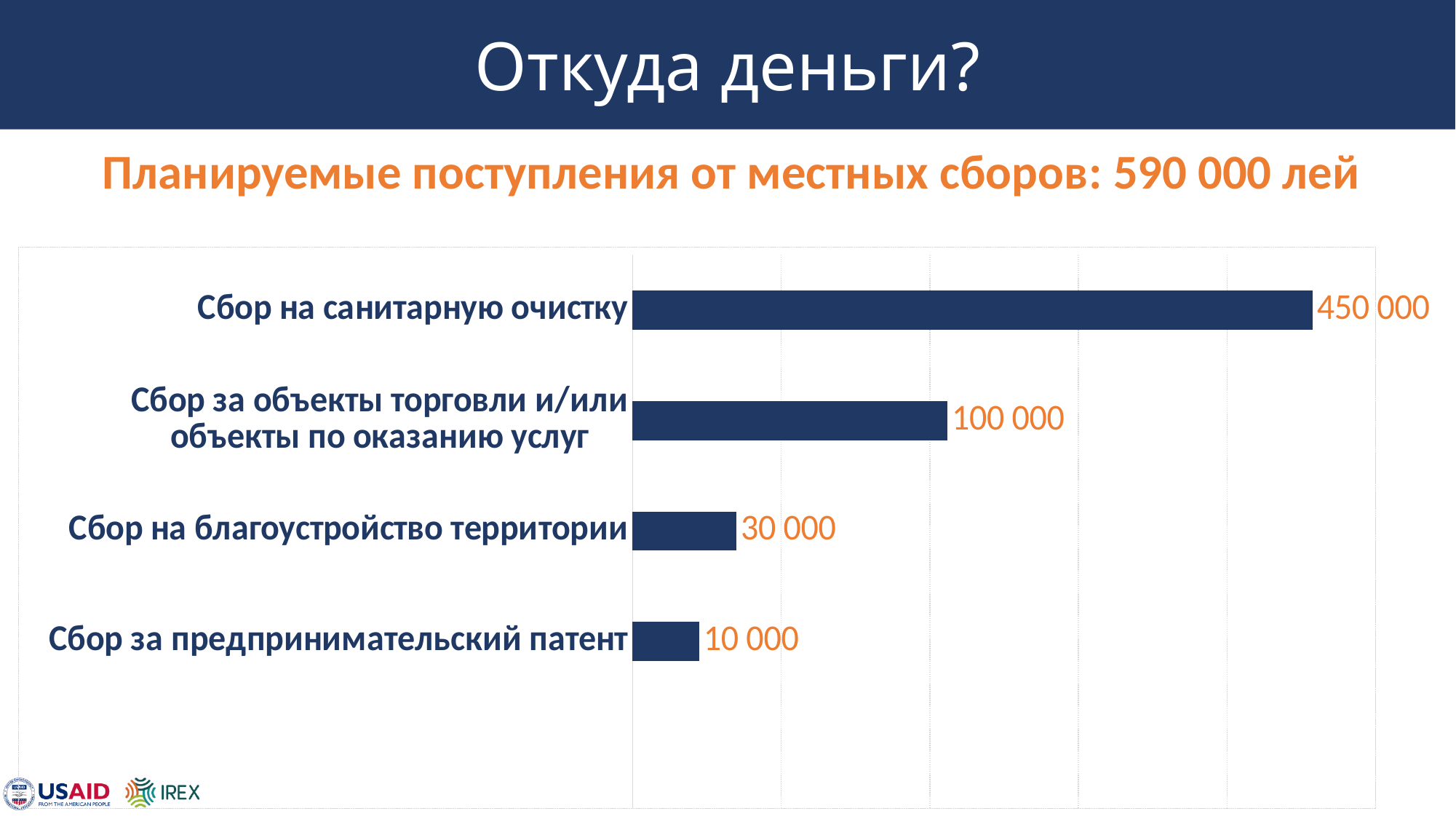
What is the value for Сбор за объекты торговли и/или объекты по оказанию услуг? 100 000 Which category has the lowest value? Сбор за предпринимательский патент What is the difference between the values for Сбор на санитарную очистку and Сбор за объекты торговли и/или объекты по оказанию услуг? 350 000 What is the difference between the values for Сбор на благоустройство территории and Сбор за предпринимательский патент? 20 000 What is the total of the four values shown in the chart? 590 000 How many categories are shown in the chart? 4 What is the value for Сбор на благоустройство территории? 30 000 What kind of chart is shown on the slide? Bar chart Which category has the highest value? Сбор на санитарную очистку What is the value for Сбор за предпринимательский патент? 10 000 Which is larger: the value for Сбор на благоустройство территории or the value for Сбор за предпринимательский патент? Сбор на благоустройство территории What is the value for Сбор на санитарную очистку? 450 000